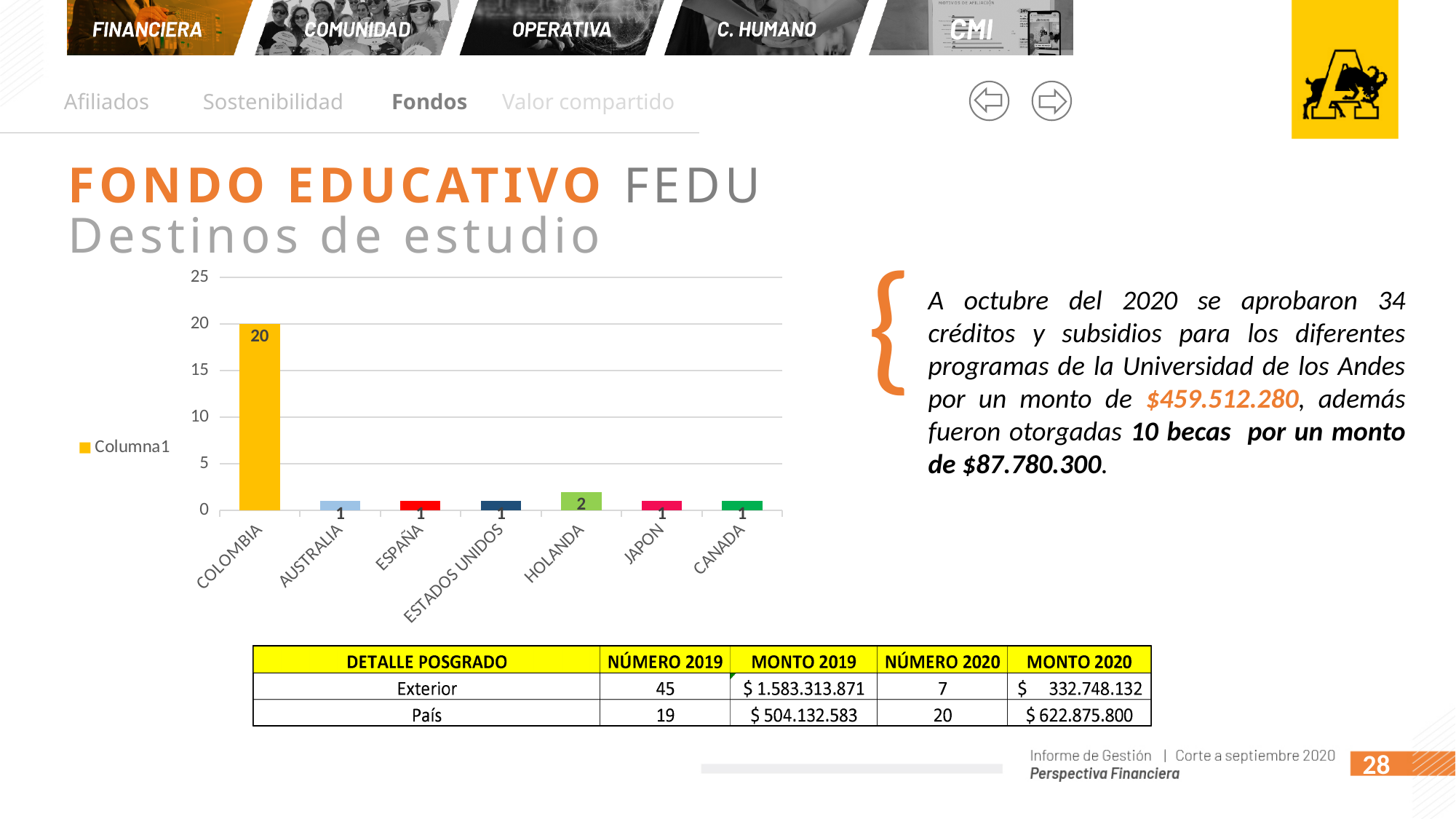
What is the value for ESTADOS UNIDOS in the bar chart? 1 What is the name of the series listed in the chart legend? Columna1 What is the difference between the values for COLOMBIA and HOLANDA? 18 What is the value for AUSTRALIA in the bar chart? 1 Which is larger, the value for HOLANDA or the value for JAPON? HOLANDA How many categories are shown on the x axis of the bar chart? 7 Is the value for COLOMBIA greater or less than 15? greater What kind of chart is shown on the slide? bar chart What is the value for HOLANDA in the bar chart? 2 What is the value for COLOMBIA in the bar chart? 20 Which category has the highest value in the bar chart? COLOMBIA How many series does the legend of the chart list? 1